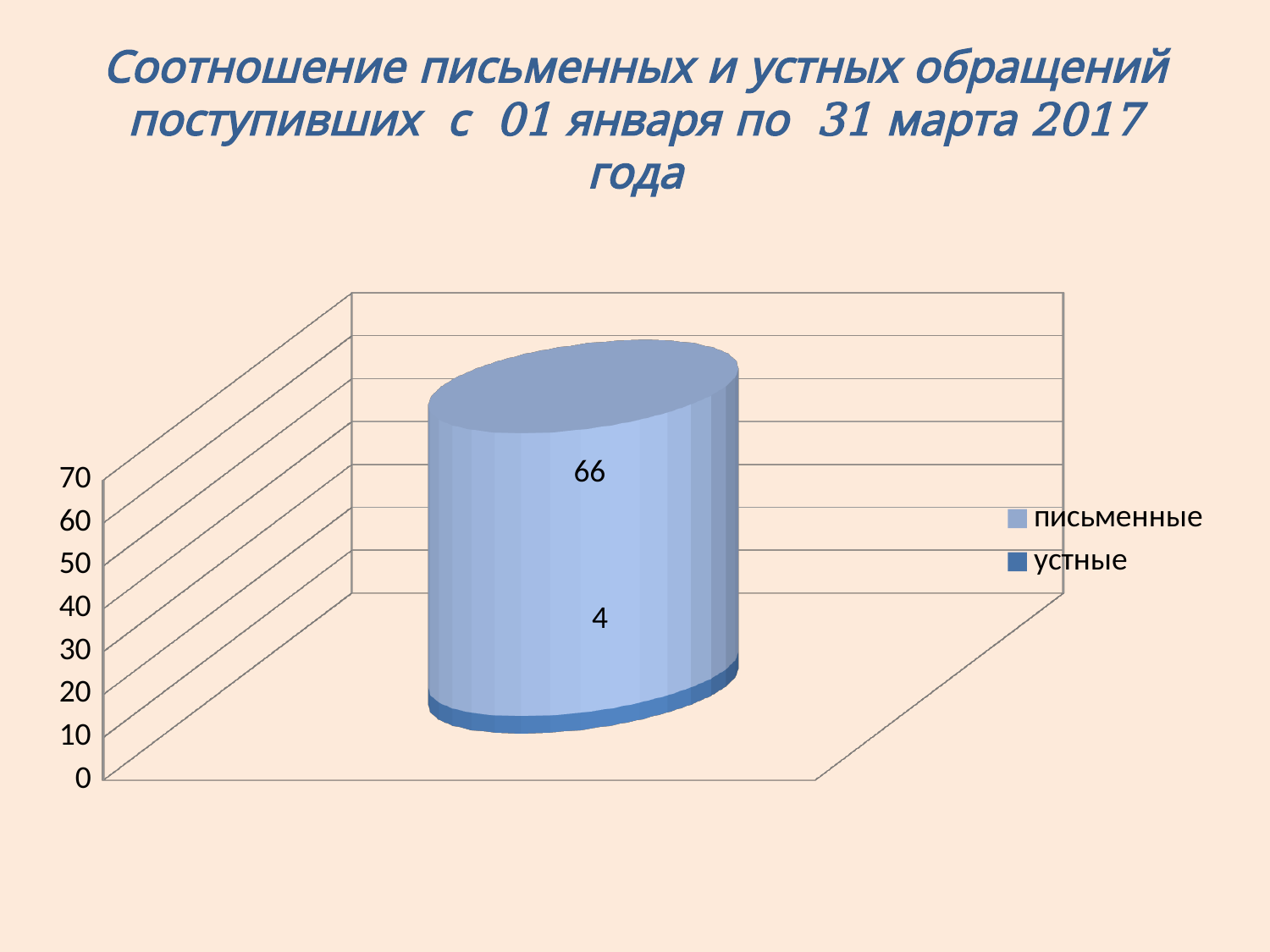
What kind of chart is shown on the slide? bar chart What is the value for письменные? 66 Which series has the larger value, письменные or устные? письменные Is the value for письменные greater or less than 50? greater Is the value for устные greater or less than 10? less Which series has the smallest value? устные Which legend entry is shown in the darker blue colour? устные What is the value for устные? 4 What is the total of the stacked bar? 70 What is the difference between the values for письменные and устные? 62 What is the highest value shown on the vertical axis? 70 How many series does the legend list? 2